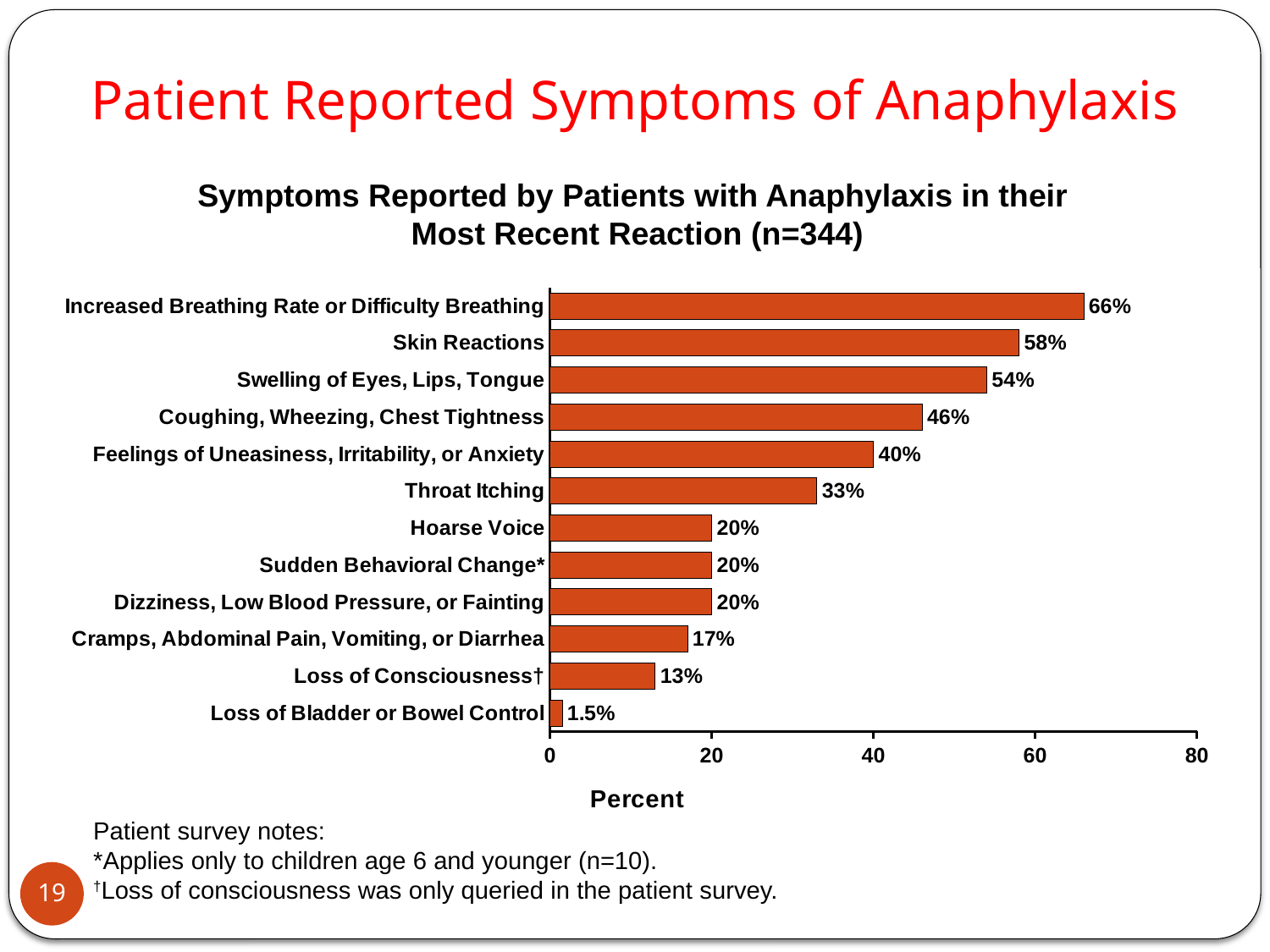
What is the difference in percentage points between Increased Breathing Rate or Difficulty Breathing and Skin Reactions? 8 What is the difference in percentage points between Coughing, Wheezing, Chest Tightness and Loss of Consciousness†? 33 Which was reported by more patients: Swelling of Eyes, Lips, Tongue or Feelings of Uneasiness, Irritability, or Anxiety? Swelling of Eyes, Lips, Tongue What is the label of the horizontal axis of the chart? Percent What type of chart is shown on the slide? Bar chart Which symptom was reported by the lowest percentage of patients? Loss of Bladder or Bowel Control Which symptom was reported by the highest percentage of patients? Increased Breathing Rate or Difficulty Breathing What percentage of patients reported Skin Reactions? 58% What percentage of patients reported Loss of Bladder or Bowel Control? 1.5% Is the value for Cramps, Abdominal Pain, Vomiting, or Diarrhea greater or less than 20? less How many symptom categories are shown in the chart? 12 What percentage of patients reported Throat Itching? 33%